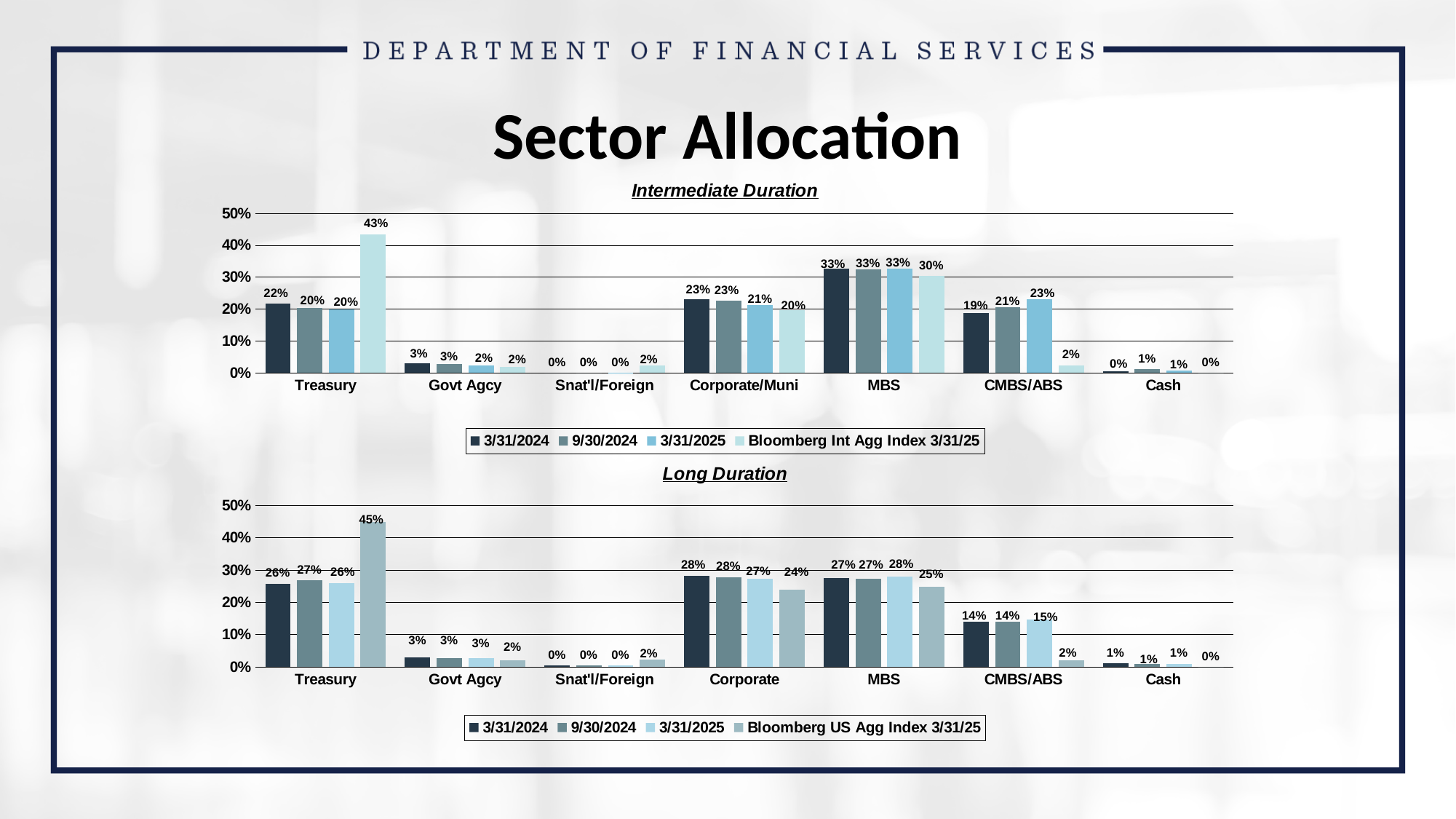
In the Intermediate Duration chart, what is the value for Treasury in the Bloomberg Int Agg Index 3/31/25 series? 43% In the Long Duration chart, what is the difference between the 3/31/2025 value and the Bloomberg US Agg Index 3/31/25 value for Treasury? 19% In the Intermediate Duration chart, which category has the highest value on 3/31/2025? MBS In the Intermediate Duration chart, what is the value for CMBS/ABS on 3/31/2025? 23% In the Intermediate Duration chart, what is the difference between the 3/31/2025 value and the Bloomberg Int Agg Index 3/31/25 value for CMBS/ABS? 21% What is the name of the fourth series in the legend of the Long Duration chart? Bloomberg US Agg Index 3/31/25 What kind of chart is the Intermediate Duration chart? Bar chart In the Long Duration chart, which is larger for MBS: the 3/31/2025 value or the Bloomberg US Agg Index 3/31/25 value? 3/31/2025 How many series does the legend of the Long Duration chart list? 4 In the Long Duration chart, what is the value for Corporate on 3/31/2024? 28% In the Long Duration chart, which category has the highest value in the Bloomberg US Agg Index 3/31/25 series? Treasury How many categories are shown on the x axis of the Intermediate Duration chart? 7